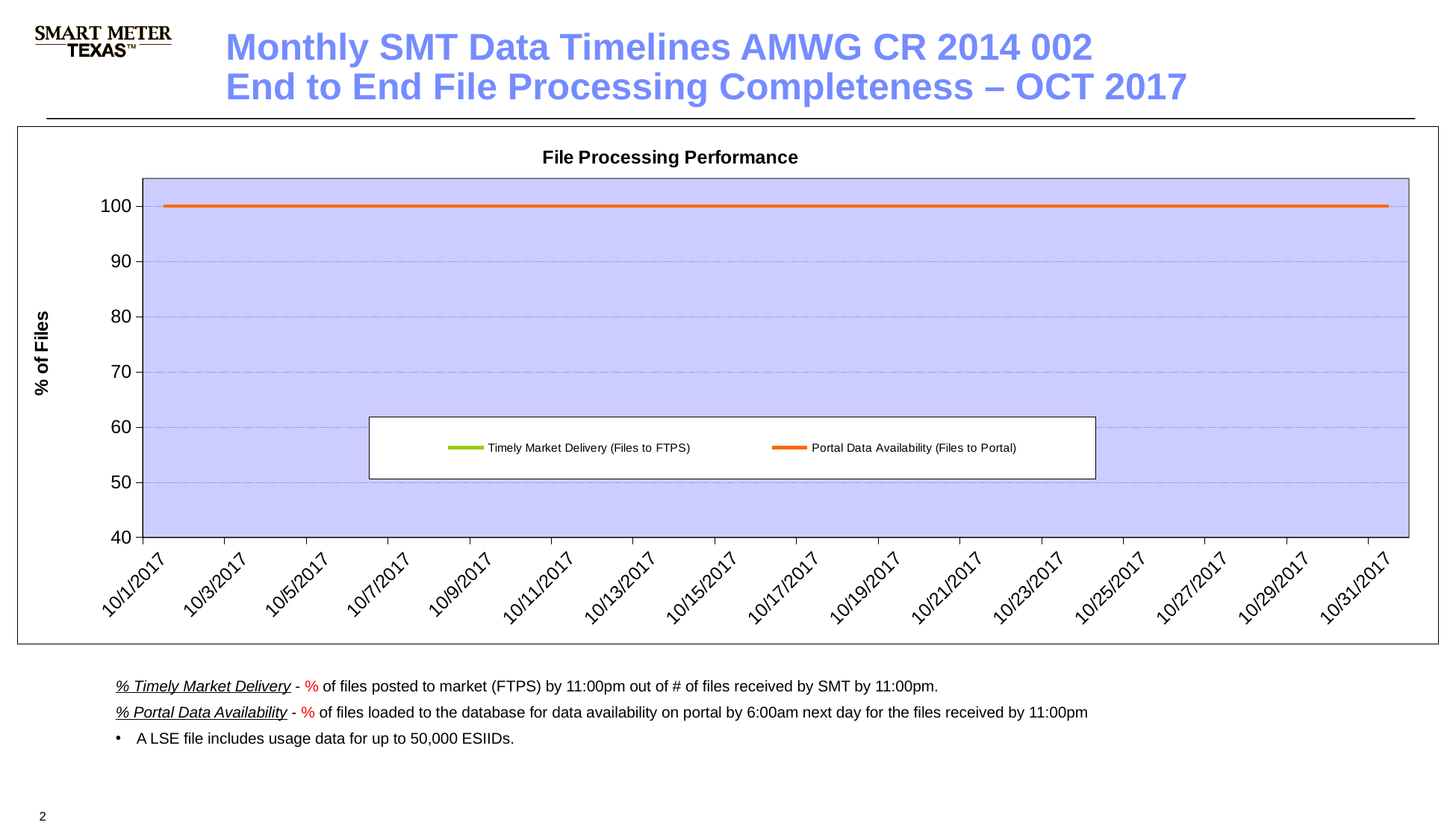
What value does the Portal Data Availability (Files to Portal) line show on 10/15/2017? 100 How many series does the legend of the File Processing Performance chart list? 2 What is the lowest value shown on the y-axis of the File Processing Performance chart? 40 Does the Portal Data Availability (Files to Portal) line rise, fall, or stay flat from 10/1/2017 to 10/31/2017? stays flat What is the title of the chart on the slide? File Processing Performance What is the first date shown on the x-axis of the File Processing Performance chart? 10/1/2017 Is the value for Portal Data Availability (Files to Portal) on 10/9/2017 greater or less than 50? greater What is the last date shown on the x-axis of the File Processing Performance chart? 10/31/2017 What kind of chart is shown under the title "File Processing Performance"? line chart Is the value for Portal Data Availability (Files to Portal) on 10/21/2017 greater or less than 90? greater What is the y-axis label of the File Processing Performance chart? % of Files What value does the Portal Data Availability (Files to Portal) line show on 10/1/2017? 100